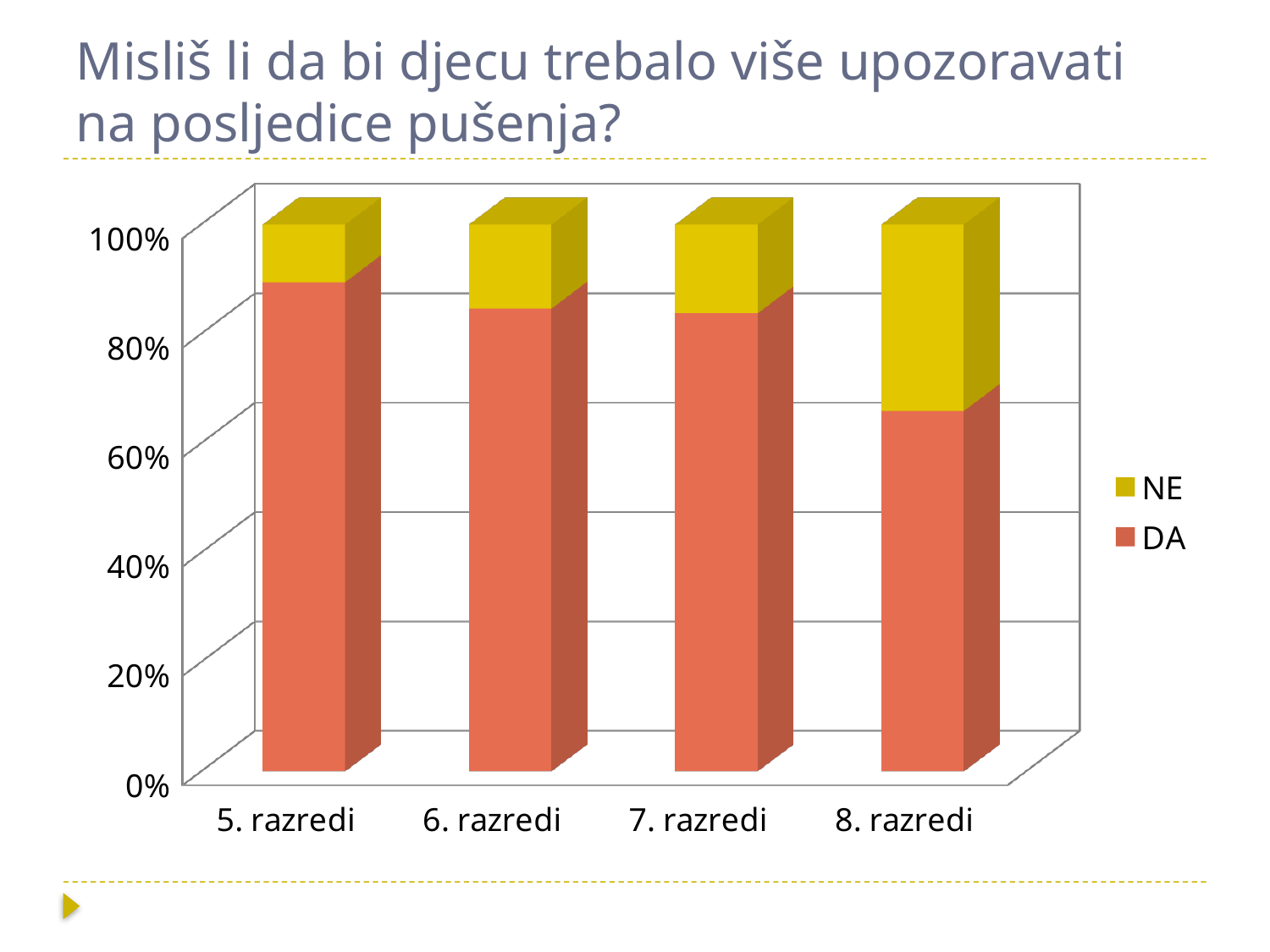
Which series are listed in the legend? NE and DA What kind of chart is shown on the slide? bar chart How many categories (classes) are shown on the x axis? 4 Is the DA share for 8. razredi greater or less than 60%? greater Which class has the highest share of NE answers? 8. razredi Which class has a larger DA share, 5. razredi or 8. razredi? 5. razredi Is the DA share for 5. razredi greater or less than 80%? greater Does the DA share rise or fall from 5. razredi to 8. razredi? fall Which class has the highest share of DA answers? 5. razredi Is the DA share for 8. razredi greater or less than 80%? less How many series does the legend list? 2 Which class has the lowest share of DA answers? 8. razredi